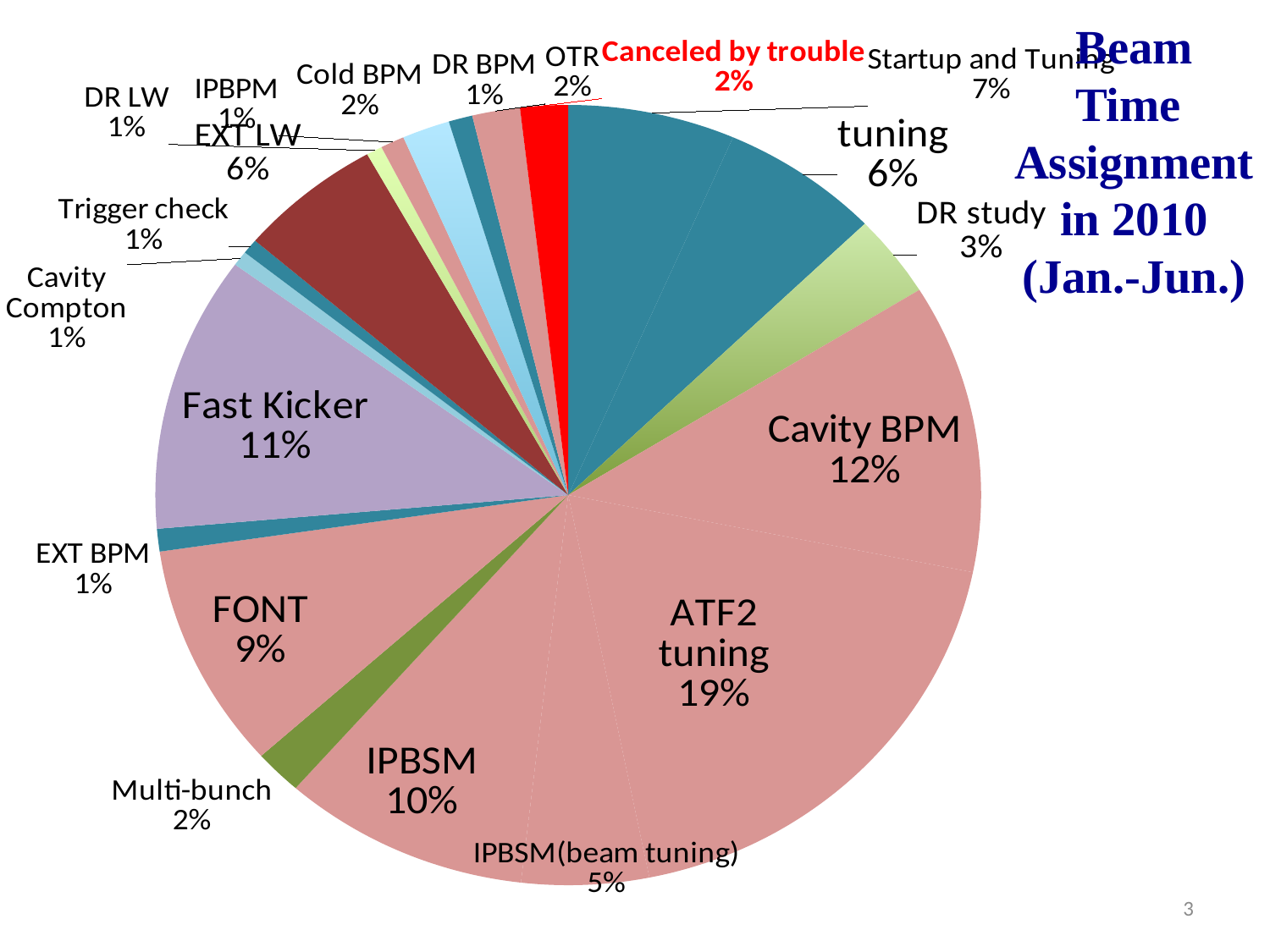
What percentage is shown for IPBSM(beam tuning)? 5% Which has a larger share, Fast Kicker or IPBSM? Fast Kicker What is the difference in percentage points between ATF2 tuning and Cavity BPM? 7 Which category has the largest share of the pie? ATF2 tuning What percentage is shown for the slice labeled 'Canceled by trouble'? 2% What percentage is shown for FONT? 9% What percentage is shown for Fast Kicker? 11% What type of chart is shown on the slide? pie chart What percentage is shown for DR study? 3% What share of beam time is assigned to ATF2 tuning? 19% What is the title of the chart? Beam Time Assignment in 2010 (Jan.-Jun.) What share of beam time is assigned to Cavity BPM? 12%